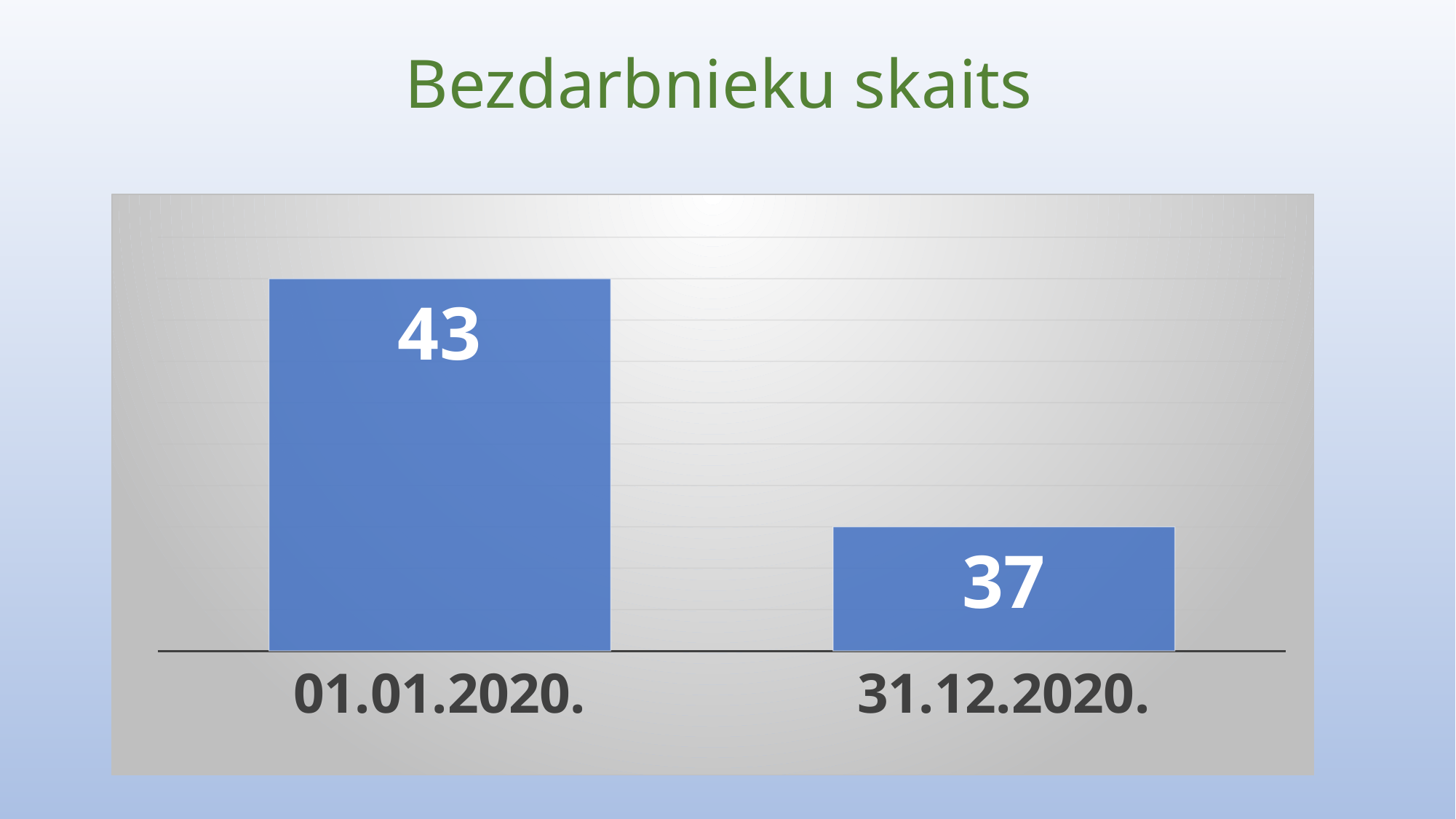
How many categories are shown in the chart? 2 What is the value for 31.12.2020.? 37 Which is larger, the value for 01.01.2020. or the value for 31.12.2020.? 01.01.2020. What colour are the bars in the chart? blue Which category has the highest value? 01.01.2020. What is the value for 01.01.2020.? 43 Which category has the lowest value? 31.12.2020. What is the difference between the values for 01.01.2020. and 31.12.2020.? 6 Do the values rise or fall from 01.01.2020. to 31.12.2020.? fall What kind of chart is shown on the slide? bar chart What is the title of the chart? Bezdarbnieku skaits